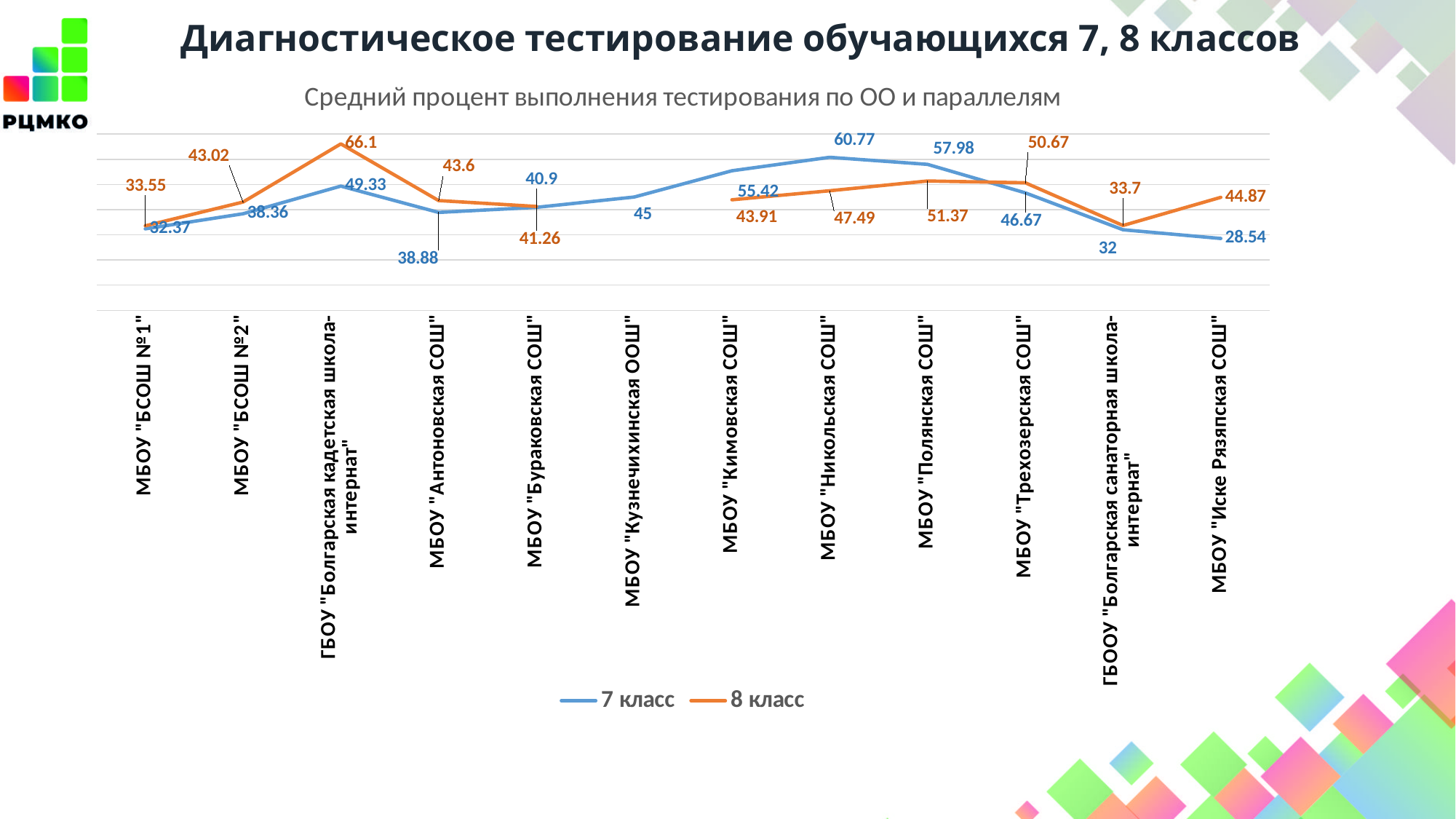
What is the value for 8 класс at МБОУ "Иске Рязяпская СОШ"? 44.87 How many series does the legend list? 2 Which school has the lowest value for 7 класс? МБОУ "Иске Рязяпская СОШ" What is the value for 7 класс at МБОУ "Никольская СОШ"? 60.77 At МБОУ "Кимовская СОШ", which series has the larger value, 7 класс or 8 класс? 7 класс Which school has the highest value for 8 класс? ГБОУ "Болгарская кадетская школа-интернат" What is the value for 7 класс at МБОУ "Кузнечихинская ООШ"? 45 How many schools are shown on the x axis? 12 What is the difference between the 8 класс and 7 класс values at ГБОУ "Болгарская кадетская школа-интернат"? 16.77 What kind of chart is shown on the slide? Line chart What is the value for 8 класс at ГБОУ "Болгарская кадетская школа-интернат"? 66.1 Which school has the highest value for 7 класс? МБОУ "Никольская СОШ"